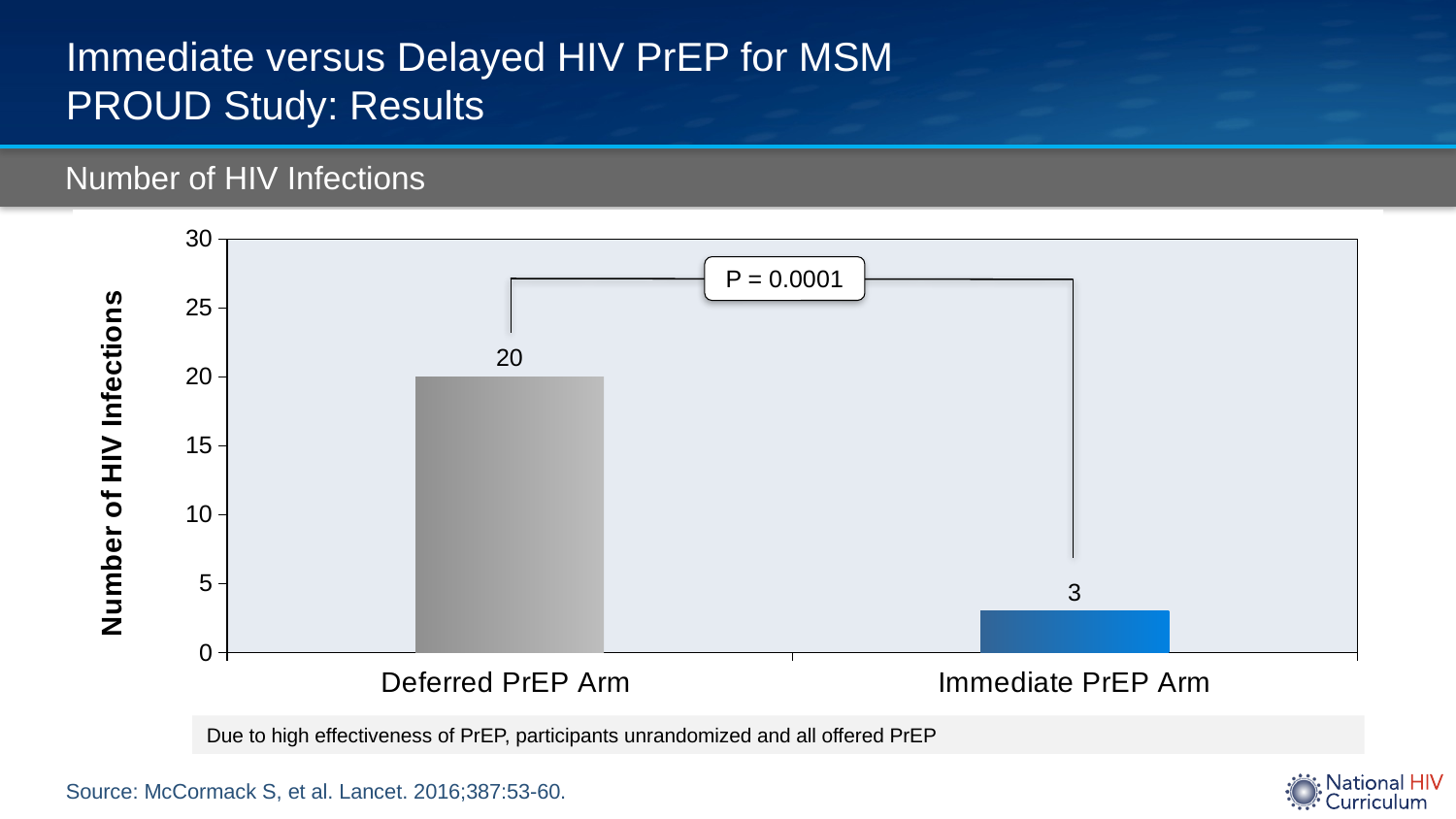
What is the number of HIV infections in the Deferred PrEP Arm? 20 What P value is shown on the chart comparing the two arms? P = 0.0001 Which arm had the lowest number of HIV infections? Immediate PrEP Arm Is the number of HIV infections in the Immediate PrEP Arm greater or less than 5? less Which arm had the highest number of HIV infections? Deferred PrEP Arm What is the difference in the number of HIV infections between the Deferred PrEP Arm and the Immediate PrEP Arm? 17 What kind of chart is shown on the slide? Bar chart What is the title of the chart? Number of HIV Infections Is the number of HIV infections in the Deferred PrEP Arm greater or less than 15? greater How many categories (arms) are shown on the chart? 2 Which arm had more HIV infections, the Deferred PrEP Arm or the Immediate PrEP Arm? Deferred PrEP Arm What is the number of HIV infections in the Immediate PrEP Arm? 3